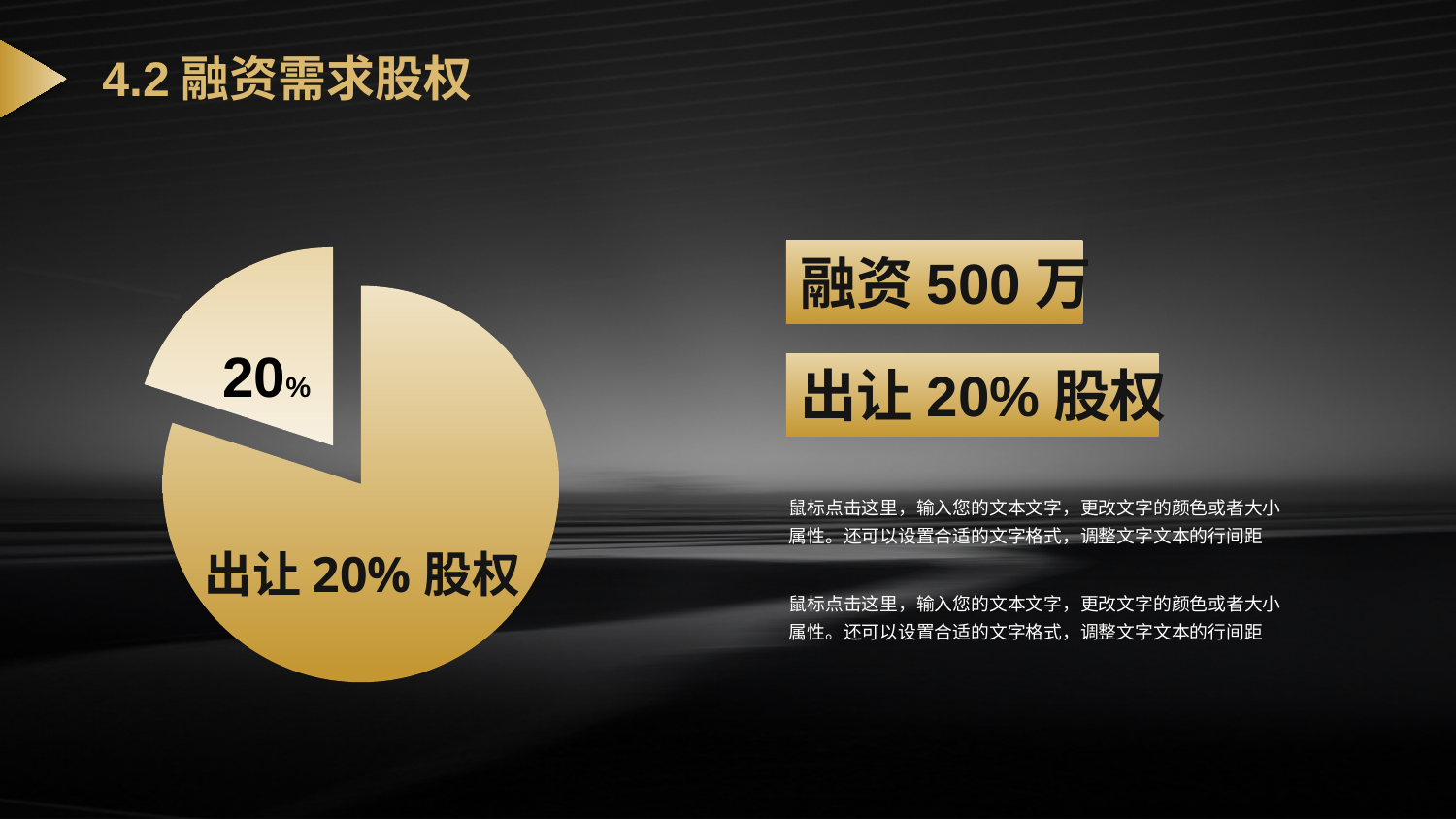
Is the exploded slice of the pie chart greater or less than 25% of the pie? less Which slice of the pie chart is larger, the exploded slice labelled 20% or the remaining slice? the remaining slice How many slices does the pie chart have? 2 What is the title of the slide containing the pie chart? 4.2 融资需求股权 What text is printed on the large slice of the pie chart? 出让 20% 股权 Is the share of the exploded slice in the pie chart greater or less than 50%? less What percentage is printed on the small exploded slice of the pie chart? 20% What kind of chart is shown on the slide? pie chart